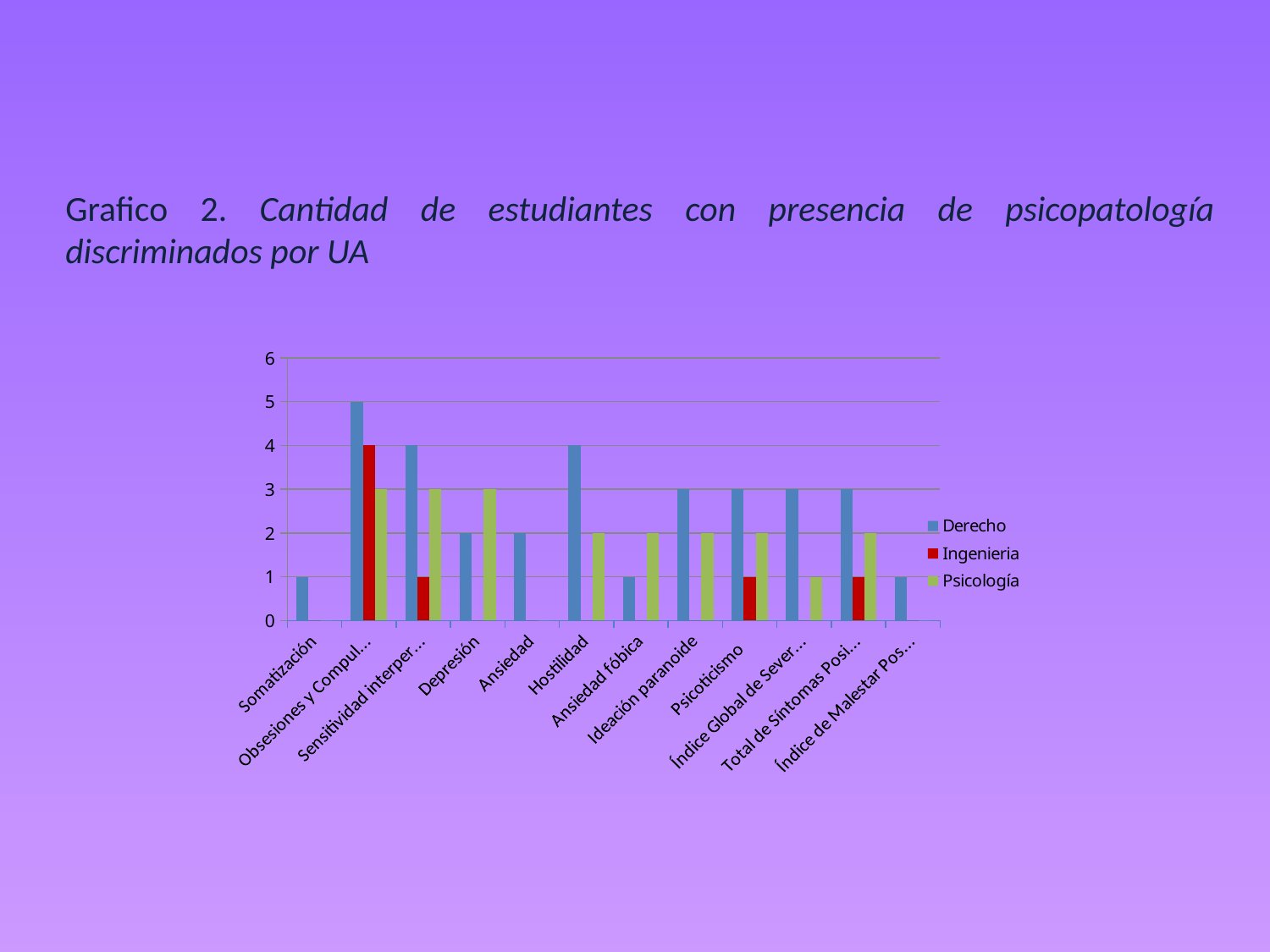
What is the value for Derecho in the Somatización category? 1 What is the value for Psicología in the Depresión category? 3 How many categories are shown on the x axis? 12 What type of chart is shown on the slide? Bar chart What is the value for Derecho in the Hostilidad category? 4 Which series has the highest value in the Ansiedad fóbica category? Psicología What is the value for Derecho in the Ansiedad category? 2 How many series does the legend list? 3 What is the value for Ingenieria in the Psicoticismo category? 1 Which is larger in the Depresión category, the Derecho value or the Psicología value? Psicología Which series is shown in red in the legend? Ingenieria What is the difference between the Derecho and Psicología values in the Ideación paranoide category? 1